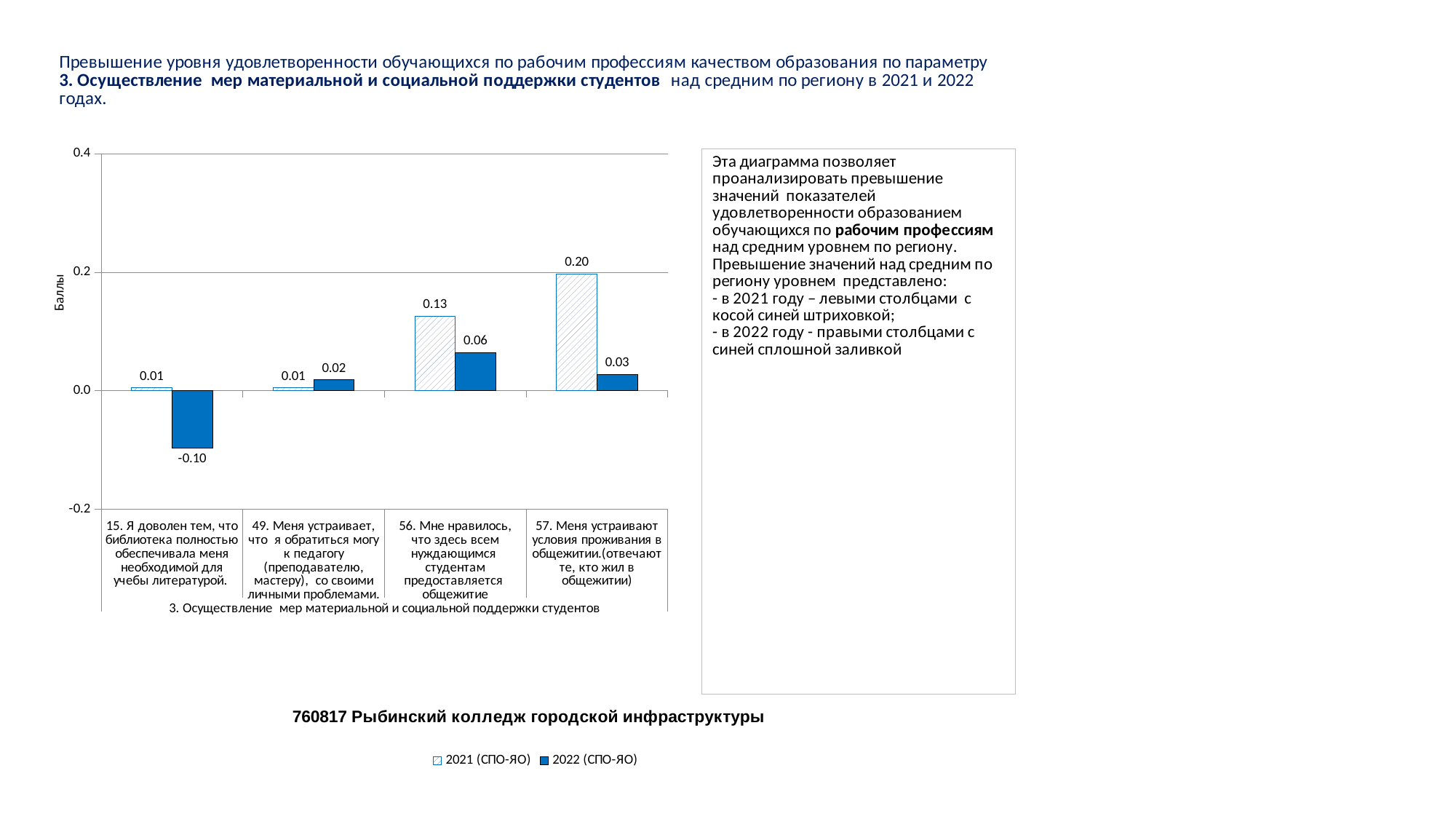
Which category has the lowest value for the 2022 (СПО-ЯО) series? 15. Я доволен тем, что библиотека полностью обеспечивала меня необходимой для учебы литературой What is the difference between the 2021 and 2022 values for category 57? 0.17 What is the label of the vertical axis of the chart? Баллы How many categories are shown on the x axis of the chart? 4 What type of chart is shown on the slide? bar chart How many series does the legend list? 2 What is the value for 2022 (СПО-ЯО) for category 56 (dormitory provided to students in need)? 0.06 What is the difference between the 2021 and 2022 values for category 56? 0.07 For category 56, which series has the larger value, 2021 (СПО-ЯО) or 2022 (СПО-ЯО)? 2021 (СПО-ЯО) What is the value for 2021 (СПО-ЯО) for category 57 (dormitory living conditions)? 0.20 Which category has the highest value for the 2021 (СПО-ЯО) series? 57. Меня устраивают условия проживания в общежитии What is the value for 2022 (СПО-ЯО) for category 15 (library literature)? -0.10